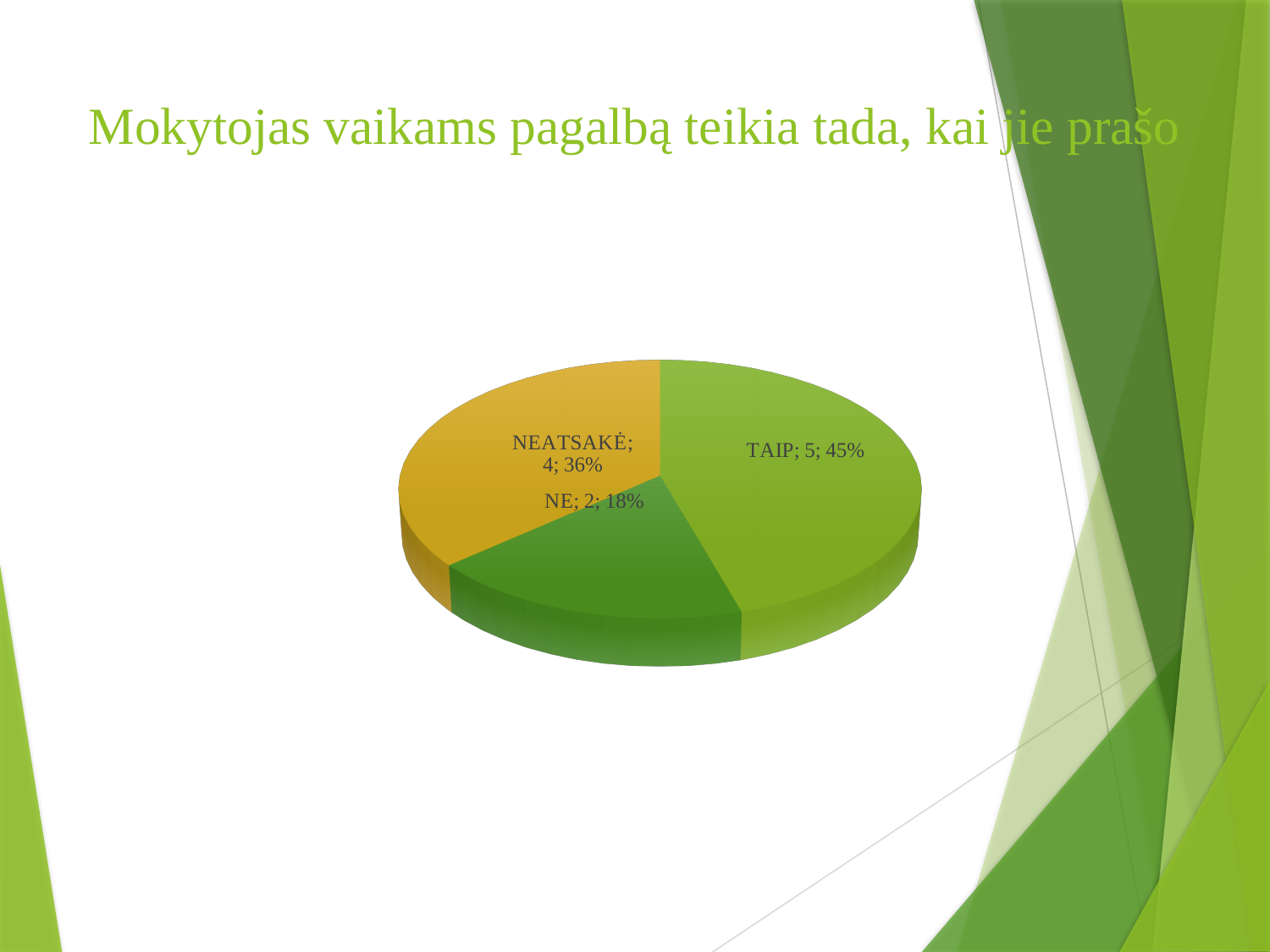
What share of the pie does NEATSAKĖ represent? 36% Which category has the largest slice? TAIP What share of the pie does NE represent? 18% What is the value for NEATSAKĖ? 4 What kind of chart is shown on the slide? pie chart What is the value for TAIP? 5 What is the value for NE? 2 What is the difference between the values for TAIP and NE? 3 How many slices does the pie chart have? 3 What share of the pie does TAIP represent? 45% Which is larger, the value for NEATSAKĖ or the value for NE? NEATSAKĖ Which category has the smallest slice? NE